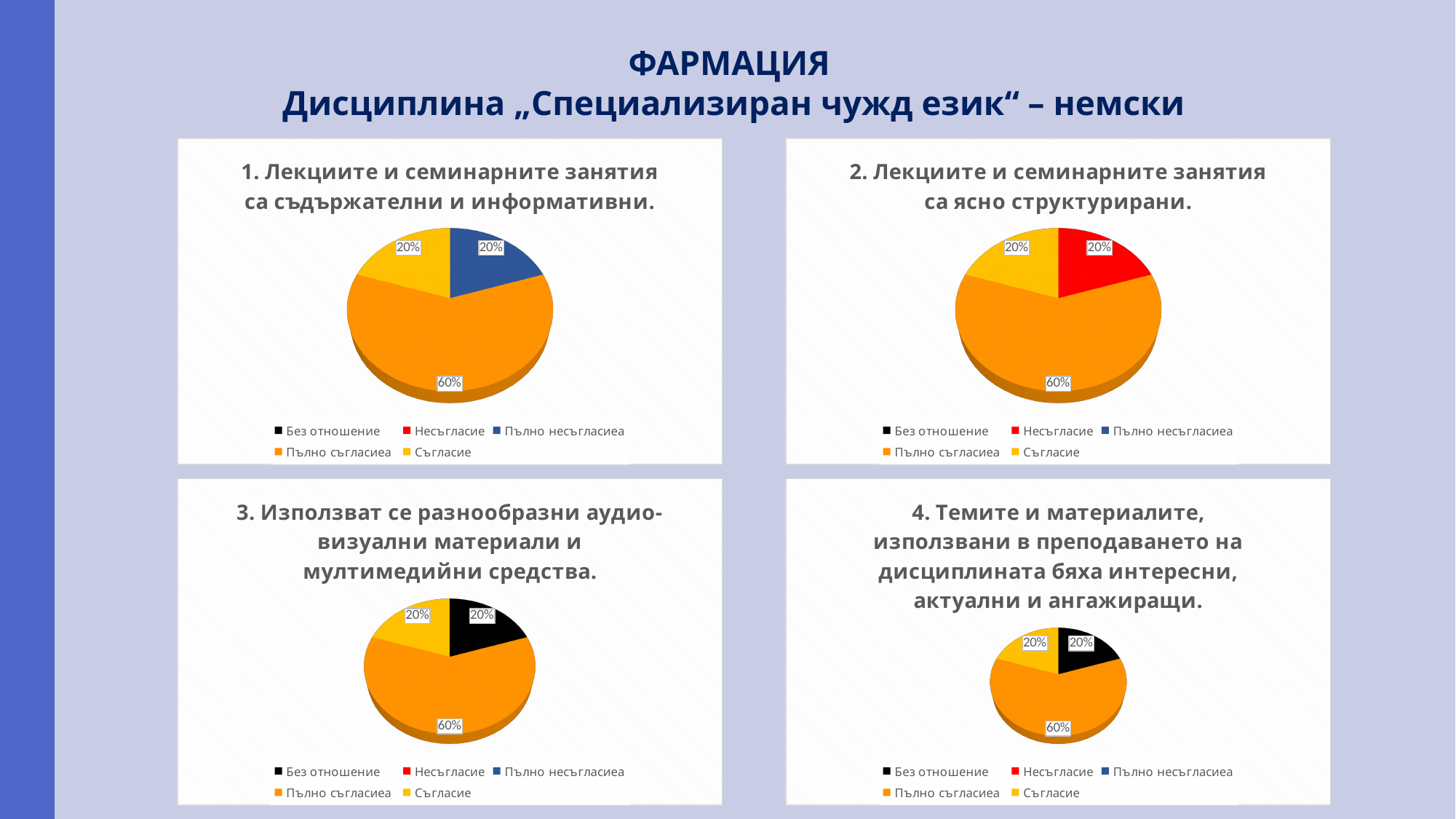
In the chart titled "2. Лекциите и семинарните занятия са ясно структурирани.", which category has the largest slice? Пълно съгласиеа In the chart titled "1. Лекциите и семинарните занятия са съдържателни и информативни.", what share does "Пълно съгласиеа" have? 60% How many entries does the legend list in the chart titled "1. Лекциите и семинарните занятия са съдържателни и информативни."? 5 In the chart titled "3. Използват се разнообразни аудио-визуални материали и мултимедийни средства.", what share does "Без отношение" have? 20% What type of chart is used in the top-left chart on the slide? Pie chart In the chart titled "4. Темите и материалите, използвани в преподаването на дисциплината бяха интересни, актуални и ангажиращи.", which is larger, "Пълно съгласиеа" or "Без отношение"? Пълно съгласиеа In the chart titled "1. Лекциите и семинарните занятия са съдържателни и информативни.", what share does "Пълно несъгласиеа" have? 20% In the chart titled "3. Използват се разнообразни аудио-визуални материали и мултимедийни средства.", what is the difference between the shares of "Пълно съгласиеа" and "Съгласие"? 40% In the chart titled "1. Лекциите и семинарните занятия са съдържателни и информативни.", what colour represents "Съгласие" in the legend? Yellow How many slices are visible in the chart titled "2. Лекциите и семинарните занятия са ясно структурирани."? 3